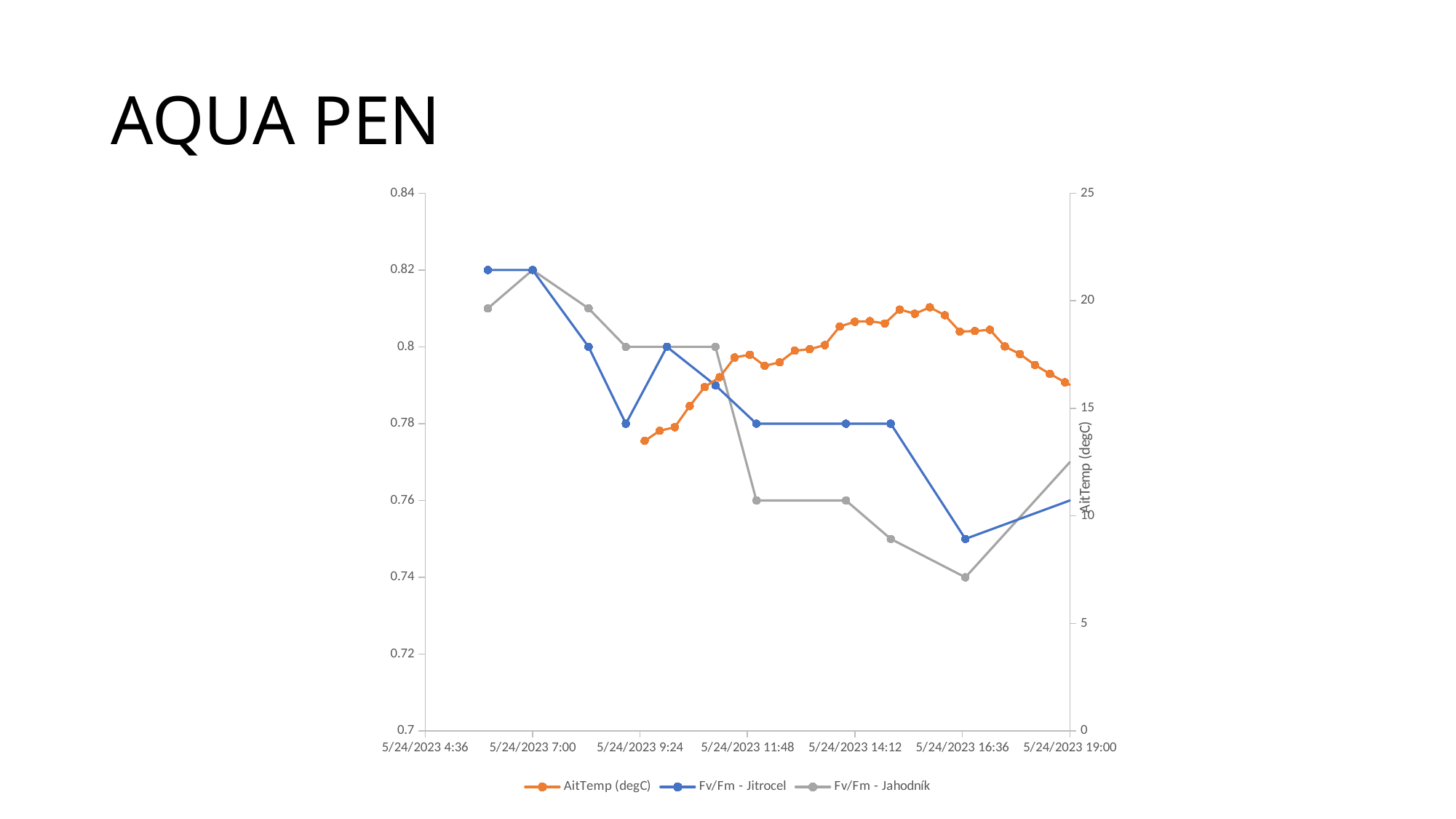
At 5/24/2023 14:12, which is higher: Fv/Fm - Jitrocel or Fv/Fm - Jahodník? Fv/Fm - Jitrocel What kind of chart is shown on the slide? line chart Is the Fv/Fm - Jahodník value at 5/24/2023 14:12 greater or less than 0.78? less What is the value of the first point of the Fv/Fm - Jitrocel series? 0.82 What are the three series named in the legend? AitTemp (degC), Fv/Fm - Jitrocel, Fv/Fm - Jahodník What is the title of the right-hand vertical axis? AitTemp (degC) Is the first AitTemp (degC) value greater or less than 15? less What is the lowest value reached by the Fv/Fm - Jahodník series? 0.74 How many series does the legend list? 3 Does the Fv/Fm - Jahodník series rise or fall between 5/24/2023 7:00 and 5/24/2023 16:36? fall What is the value of Fv/Fm - Jitrocel at 5/24/2023 14:12? 0.78 Is the AitTemp (degC) value at 5/24/2023 16:36 greater or less than 15? greater